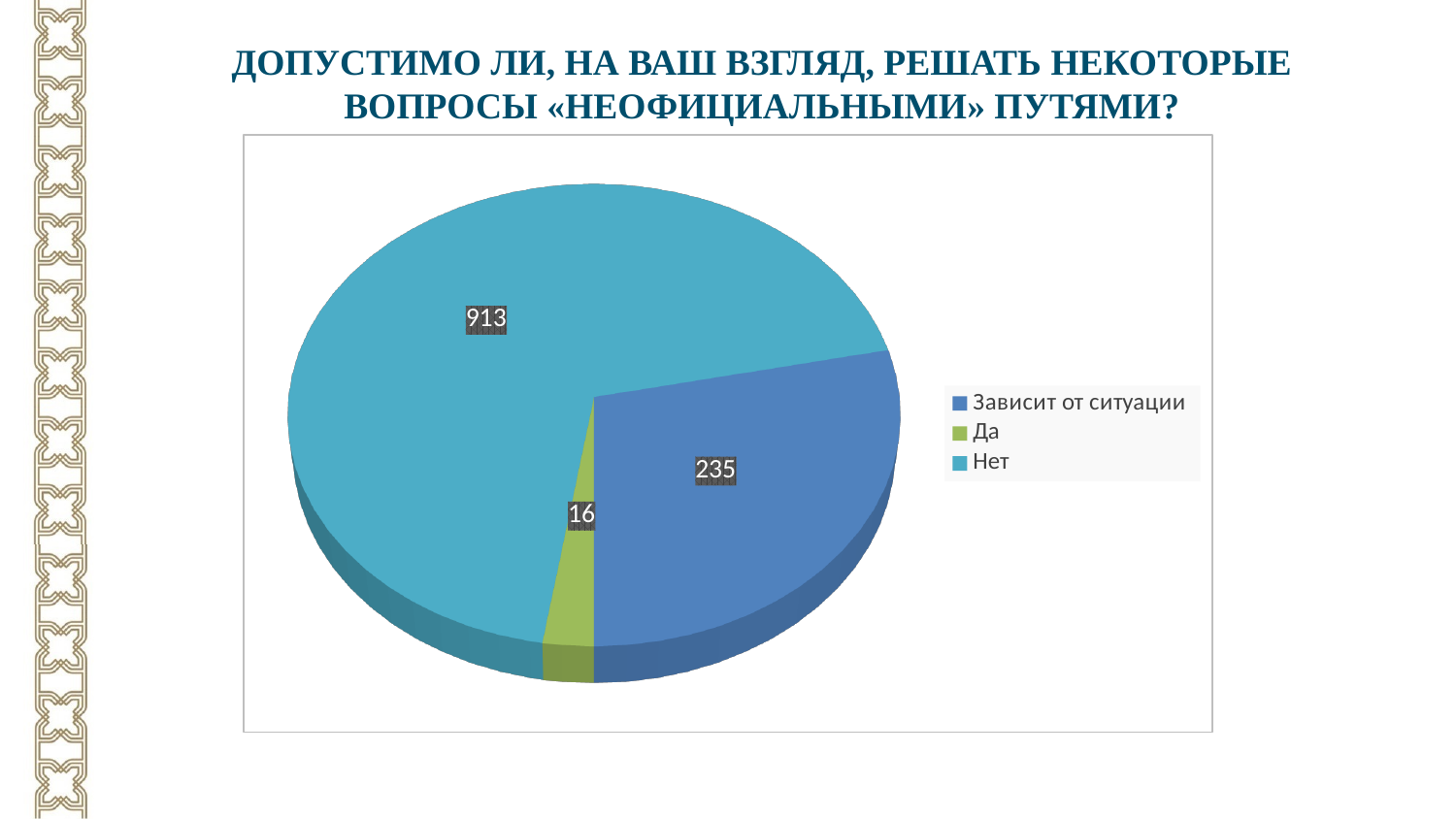
How many categories does the pie chart have? 3 What is the value for "Нет"? 913 What is the value for "Зависит от ситуации"? 235 What is the value for "Да"? 16 What is the difference between the values for "Зависит от ситуации" and "Да"? 219 Which is larger: the value for "Зависит от ситуации" or the value for "Да"? Зависит от ситуации Which category has the largest slice? Нет What is the total of all slices in the pie chart? 1164 Which colour represents "Да" in the legend? Green What type of chart is shown on the slide? Pie chart What is the difference between the values for "Нет" and "Зависит от ситуации"? 678 Which category has the smallest slice? Да